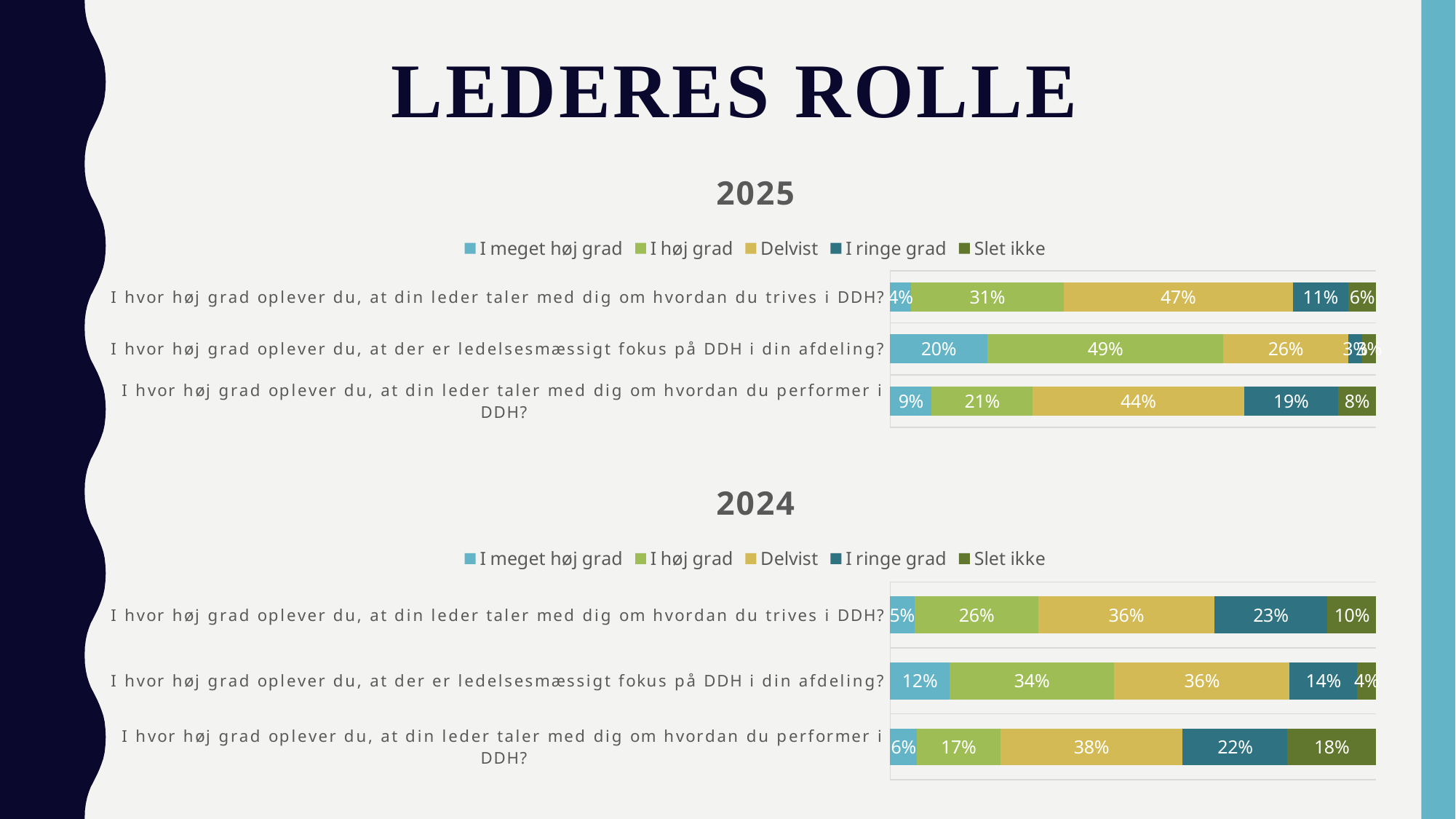
In the 2024 chart, what is the value for "Slet ikke" for the question about whether your leader talks with you about how you perform in DDH? 18% In the 2024 chart, what is the difference between the "Delvist" value and the "I høj grad" value for the question about whether your leader talks with you about how you perform in DDH? 21% In the 2025 chart, what is the value for "I høj grad" for the question about management focus (ledelsesmæssigt fokus) on DDH in your department? 49% In the 2024 chart, what is the value for "I meget høj grad" for the question about management focus (ledelsesmæssigt fokus) on DDH in your department? 12% In the 2025 chart, what is the value for "Delvist" for the question about whether your leader talks with you about how you thrive (trives) in DDH? 47% How many questions (categories) are shown in the 2024 chart? 3 In the 2025 chart, which question has the lowest "I meget høj grad" value? I hvor høj grad oplever du, at din leder taler med dig om hvordan du trives i DDH? In the 2025 chart, what is the value for "I ringe grad" for the question about whether your leader talks with you about how you perform in DDH? 19% How many series does the legend of the 2025 chart list? 5 What kind of chart is the 2025 chart? Stacked bar chart In the 2024 chart, which question has the highest "I ringe grad" value? I hvor høj grad oplever du, at din leder taler med dig om hvordan du trives i DDH? Which is larger: the "Slet ikke" value for the performer question in the 2024 chart or in the 2025 chart? 2024